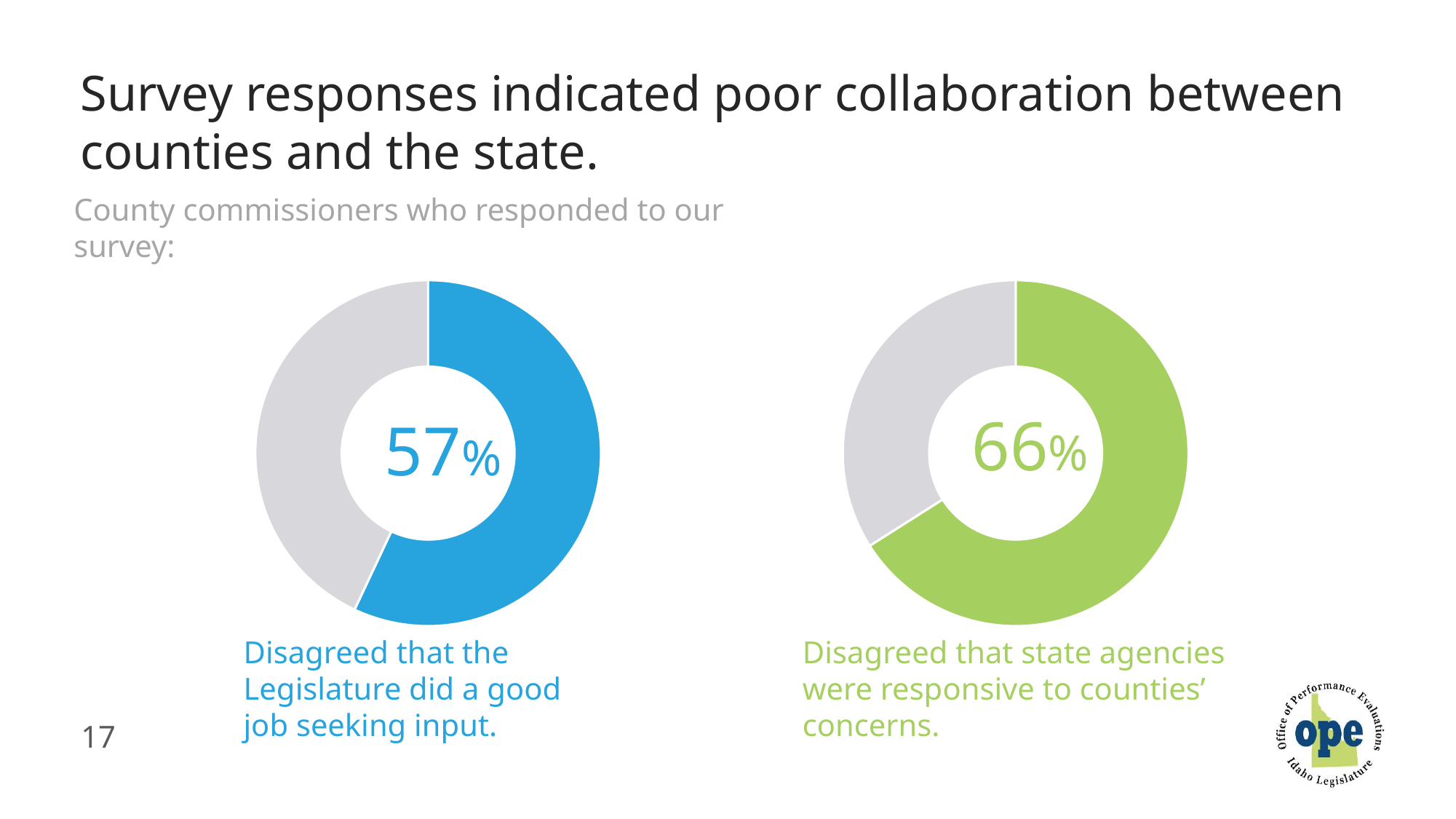
In the left donut chart, what percentage of county commissioners disagreed that the Legislature did a good job seeking input? 57% Is the value shown in the left donut chart greater or less than 50%? greater Is the value shown in the right donut chart greater or less than 75%? less In the right donut chart, what percentage of county commissioners disagreed that state agencies were responsive to counties' concerns? 66% What colour is the highlighted segment in the right donut chart? Green What is the difference in percentage points between the value in the right donut chart (66%) and the value in the left donut chart (57%)? 9 percentage points Which is larger: the share who disagreed that the Legislature did a good job seeking input, or the share who disagreed that state agencies were responsive to counties' concerns? Disagreed that state agencies were responsive to counties' concerns How many donut charts are shown on the slide? 2 What kind of chart is used on this slide to show the survey results? Donut (pie) chart What colour is the highlighted segment in the left donut chart? Blue Which group of respondents do the donut charts describe, according to the subtitle? County commissioners who responded to our survey